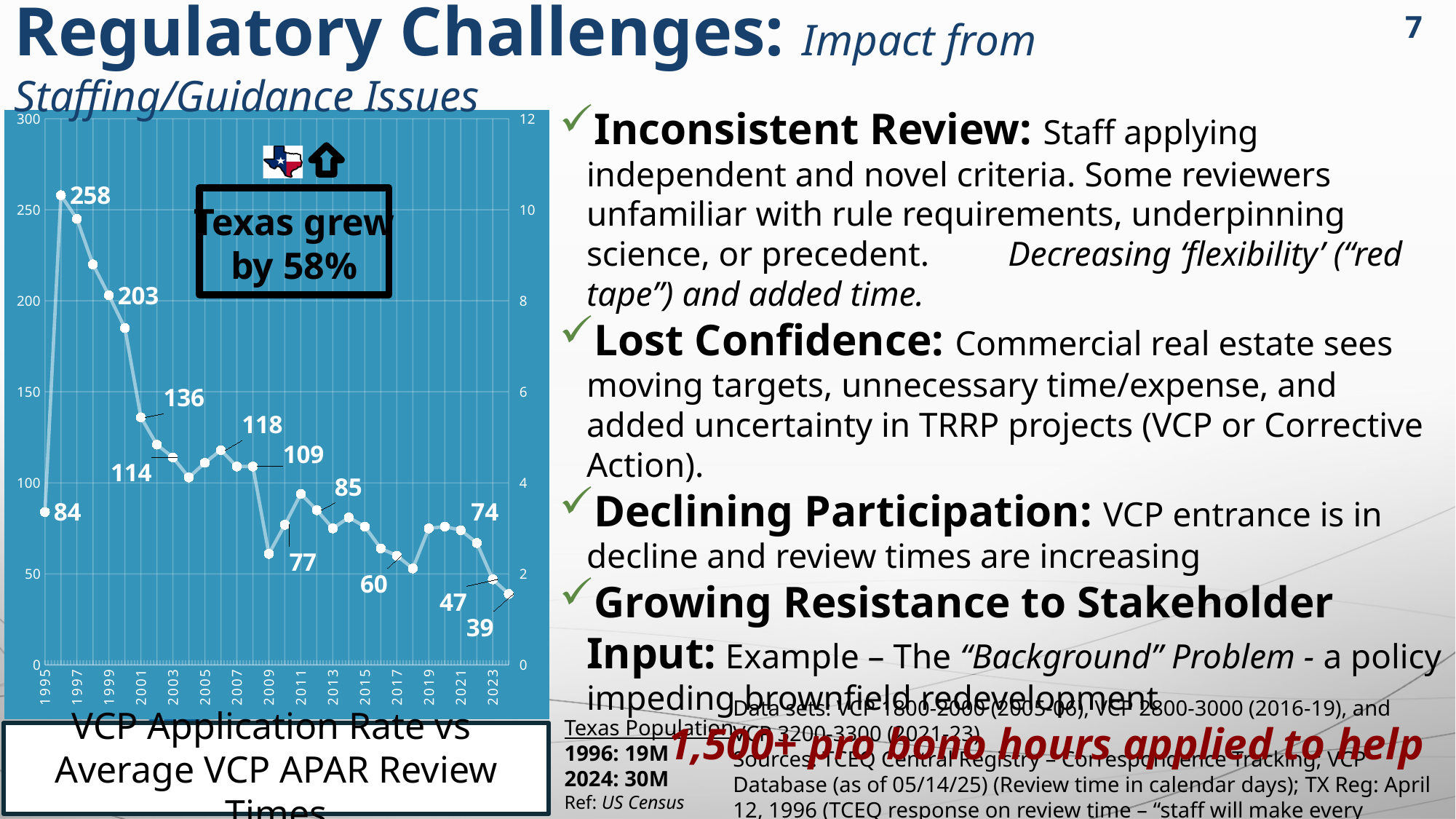
What is the title of the chart? VCP Application Rate vs Average VCP APAR Review Times What kind of chart is shown on the slide? line chart Which labeled value is larger, 136 or 114? 136 After the peak in 1996, do the values generally rise or fall toward 2023? fall What is the highest value labeled on the chart? 258 What is the value plotted for 1995, the first point on the chart? 84 What is the maximum value shown on the left vertical axis? 300 What is the difference between the labeled values 258 and 203? 55 What is the lowest value labeled on the chart? 39 Is the value for 2018 greater or less than 100? less What is the difference between the highest labeled value (258) and the lowest labeled value (39)? 219